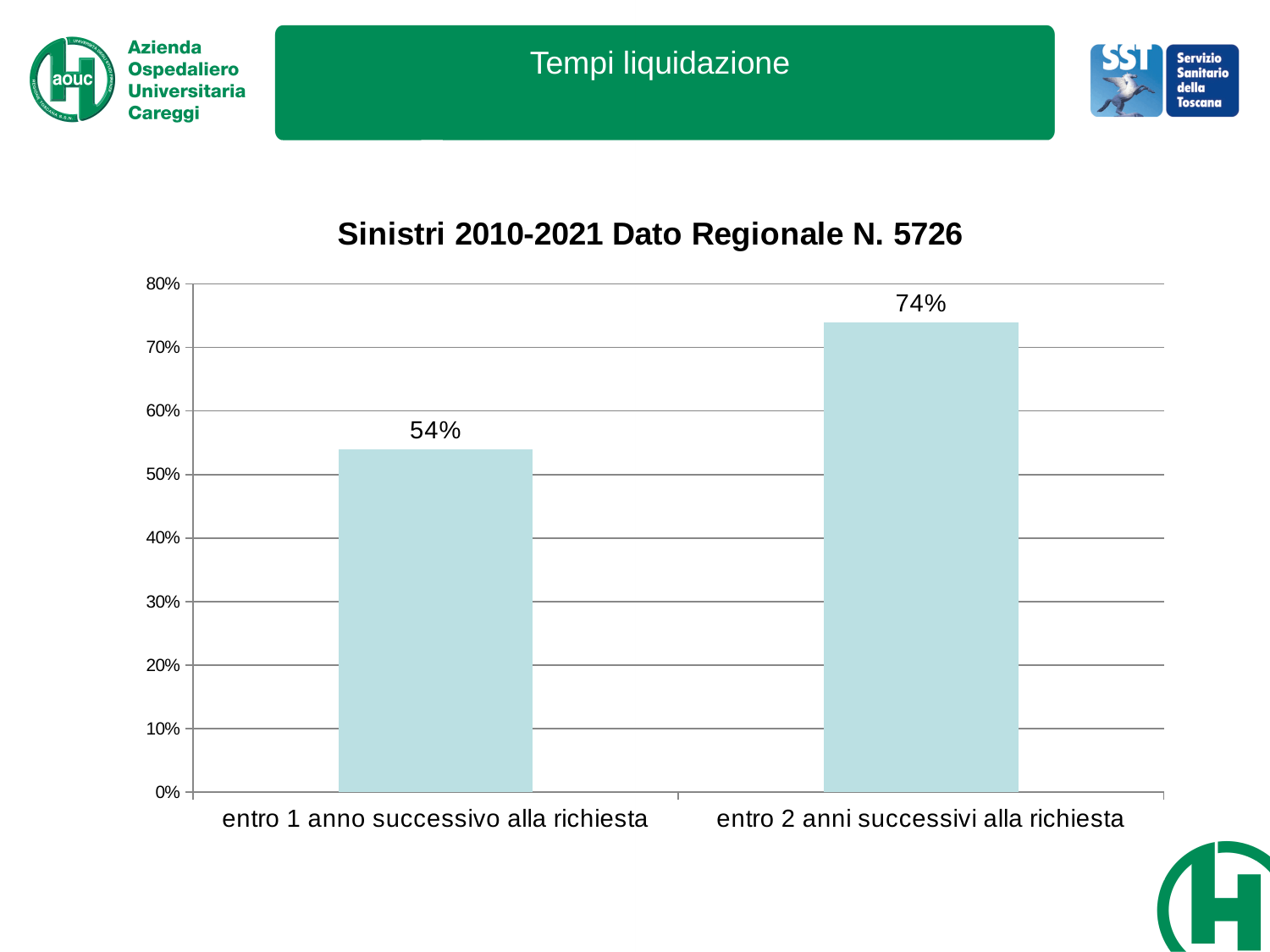
Do the values rise or fall from left to right along the x axis? rise Which category has the lowest value? entro 1 anno successivo alla richiesta What is the value for "entro 1 anno successivo alla richiesta"? 54% Which category has the highest value? entro 2 anni successivi alla richiesta How many categories are shown on the chart? 2 Is the value for "entro 2 anni successivi alla richiesta" greater or less than 70%? greater Which is larger: the value for "entro 1 anno successivo alla richiesta" or "entro 2 anni successivi alla richiesta"? entro 2 anni successivi alla richiesta What is the title of the chart? Sinistri 2010-2021 Dato Regionale N. 5726 What is the difference between the values for "entro 2 anni successivi alla richiesta" and "entro 1 anno successivo alla richiesta"? 20% What kind of chart is shown on the slide? bar chart Is the value for "entro 1 anno successivo alla richiesta" greater or less than 60%? less What is the value for "entro 2 anni successivi alla richiesta"? 74%